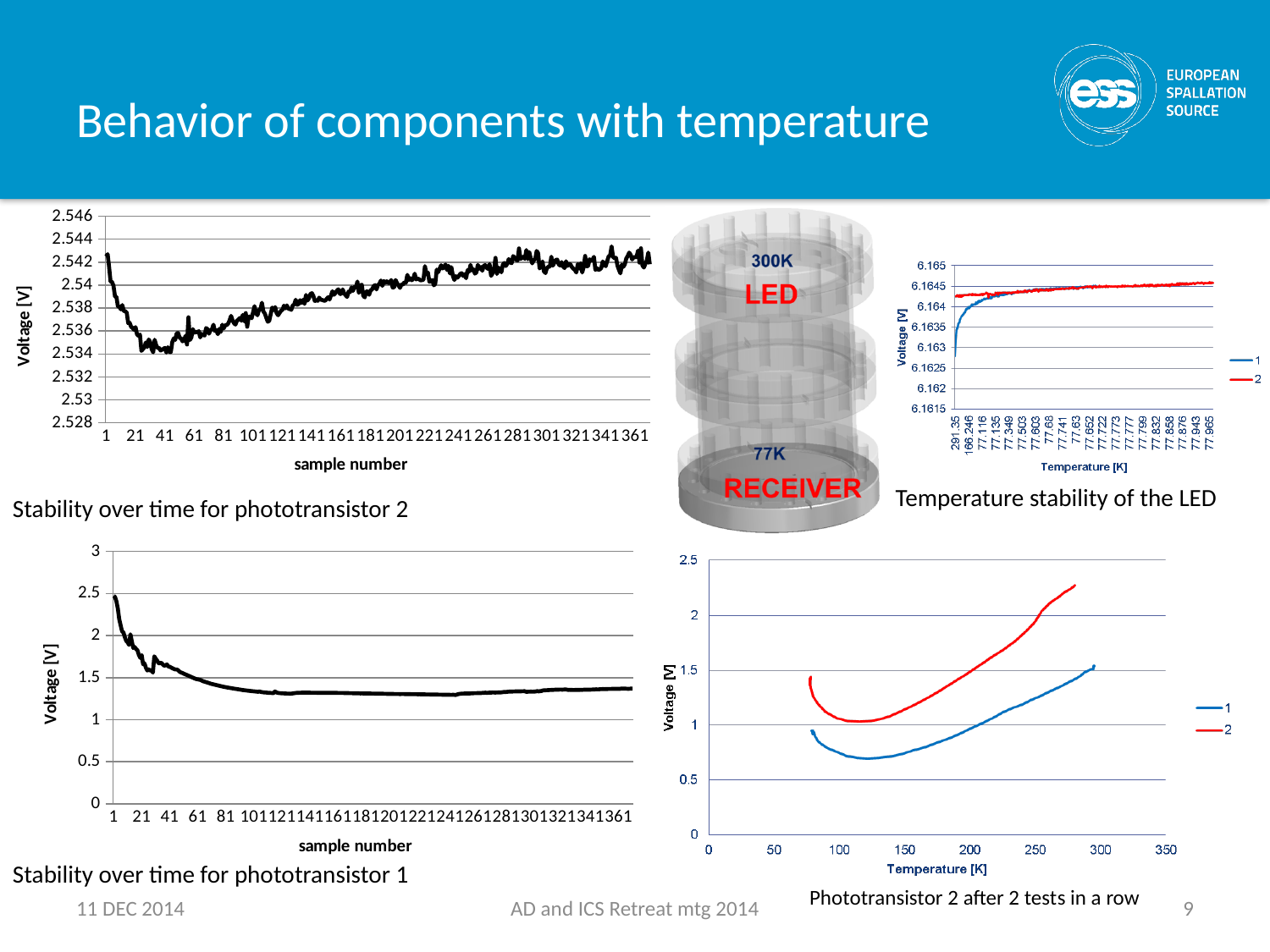
How many series does the legend of the 'Phototransistor 2 after 2 tests in a row' chart list? 2 What is the x-axis label of the 'Temperature stability of the LED' chart? Temperature [K] In the 'Stability over time for phototransistor 1' chart, is the voltage at sample number 1 greater or less than 2? greater In the 'Phototransistor 2 after 2 tests in a row' chart, is the voltage of series 2 at 250 K greater or less than 1.5? greater In the 'Stability over time for phototransistor 2' chart, is the voltage at sample number 41 greater or less than 2.536? less How many series does the legend of the 'Temperature stability of the LED' chart list? 2 What kind of chart is the 'Stability over time for phototransistor 2' chart? line chart In the 'Stability over time for phototransistor 1' chart, does the voltage rise or fall over the first 100 samples? fall In the 'Phototransistor 2 after 2 tests in a row' chart, which series has the higher voltage at 250 K, series 1 or series 2? series 2